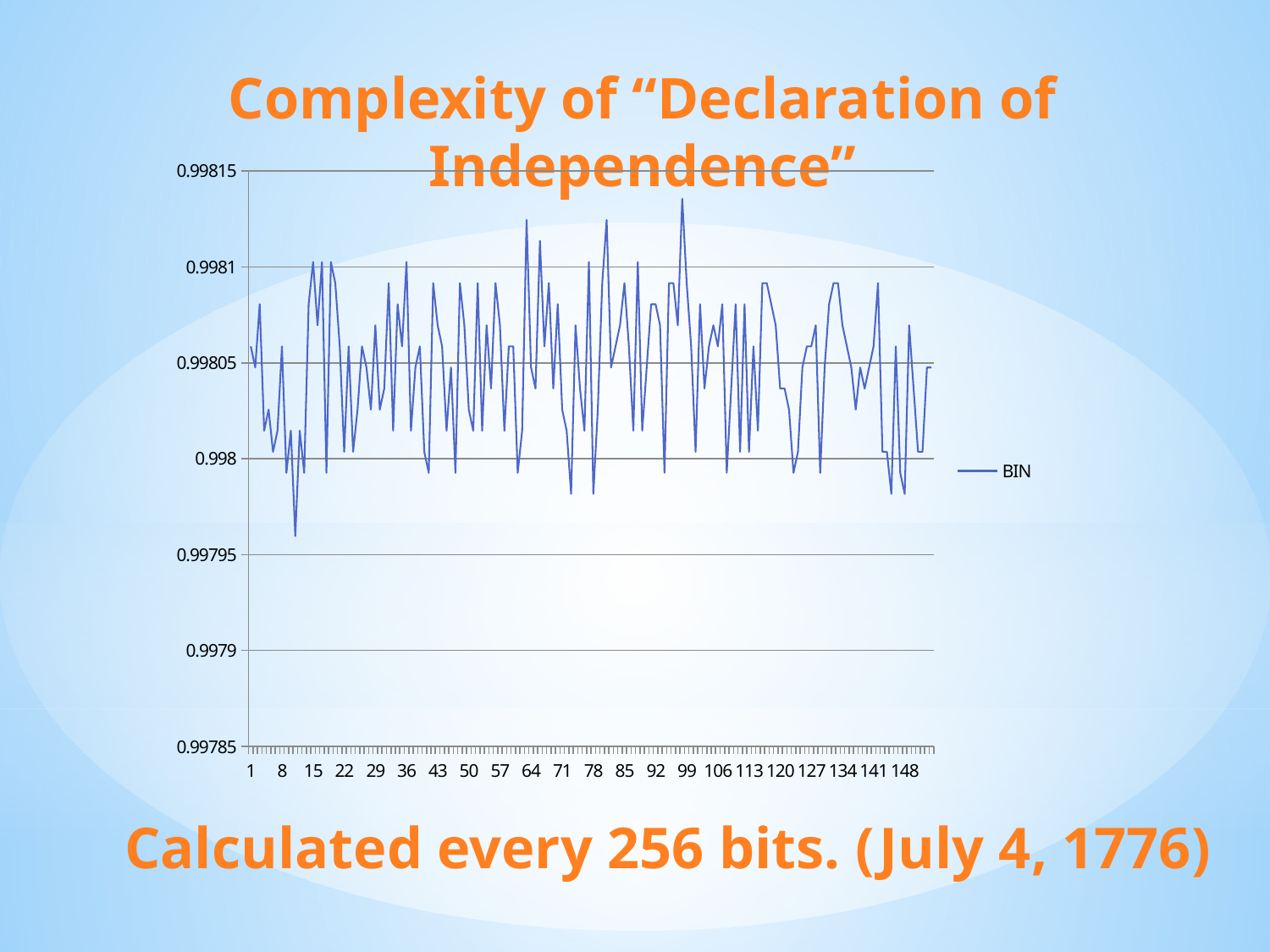
What is the last label shown on the x axis? 148 What is the title of the chart? Complexity of "Declaration of Independence" What is the lowest value labelled on the y axis? 0.99785 How many series does the legend list? 1 What kind of chart is shown on the slide? Line chart Does the BIN line show a steady rise, a steady fall, or fluctuation across the x axis? Fluctuation What is the highest value labelled on the y axis? 0.99815 Is the highest point of the BIN line greater or less than 0.9981? greater Is the lowest point of the BIN line greater or less than 0.998? less How many labels are printed along the x axis? 22 Is the lowest point of the BIN line greater or less than 0.9979? greater What is the name of the series shown in the legend? BIN